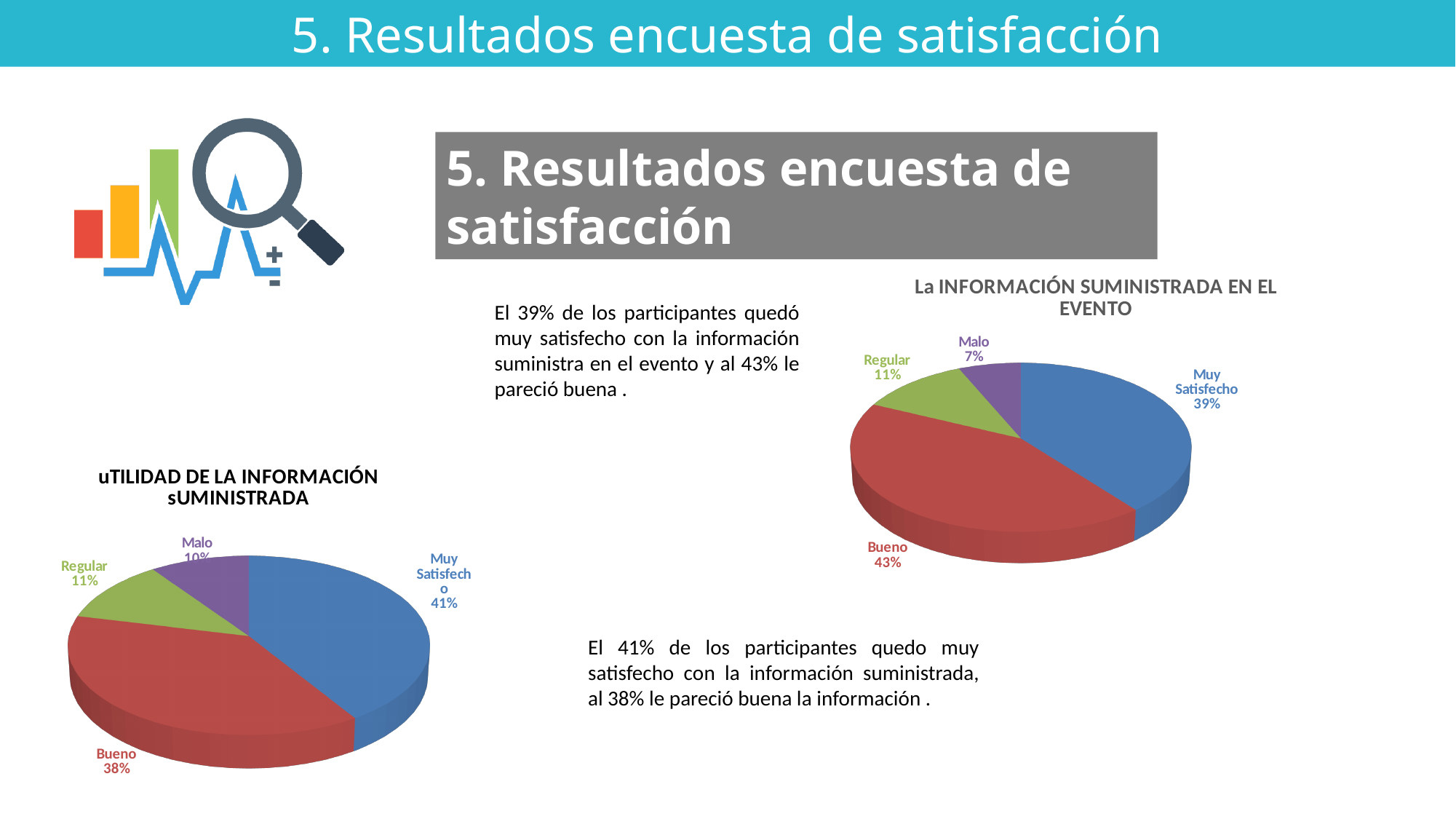
In the chart titled "uTILIDAD DE LA INFORMACIÓN sUMINISTRADA", how many categories are shown? 4 In the chart titled "La INFORMACIÓN SUMINISTRADA EN EL EVENTO", which category has the smallest slice? Malo In the chart titled "uTILIDAD DE LA INFORMACIÓN sUMINISTRADA", which is larger, Regular or Malo? Regular What kind of chart is the one titled "La INFORMACIÓN SUMINISTRADA EN EL EVENTO"? Pie chart In the chart titled "La INFORMACIÓN SUMINISTRADA EN EL EVENTO", what is the difference in percentage points between Bueno and Muy Satisfecho? 4 In the chart titled "uTILIDAD DE LA INFORMACIÓN sUMINISTRADA", what percentage is labelled for Malo? 10% In the chart titled "uTILIDAD DE LA INFORMACIÓN sUMINISTRADA", which category has the largest slice? Muy Satisfecho In the chart titled "La INFORMACIÓN SUMINISTRADA EN EL EVENTO", what percentage is labelled for Malo? 7% In the chart titled "La INFORMACIÓN SUMINISTRADA EN EL EVENTO", which category has the largest slice? Bueno In the chart titled "La INFORMACIÓN SUMINISTRADA EN EL EVENTO", what percentage is labelled for Bueno? 43% In the chart titled "uTILIDAD DE LA INFORMACIÓN sUMINISTRADA", what percentage is labelled for Muy Satisfecho? 41% In the chart titled "uTILIDAD DE LA INFORMACIÓN sUMINISTRADA", what colour is the Bueno slice? Red